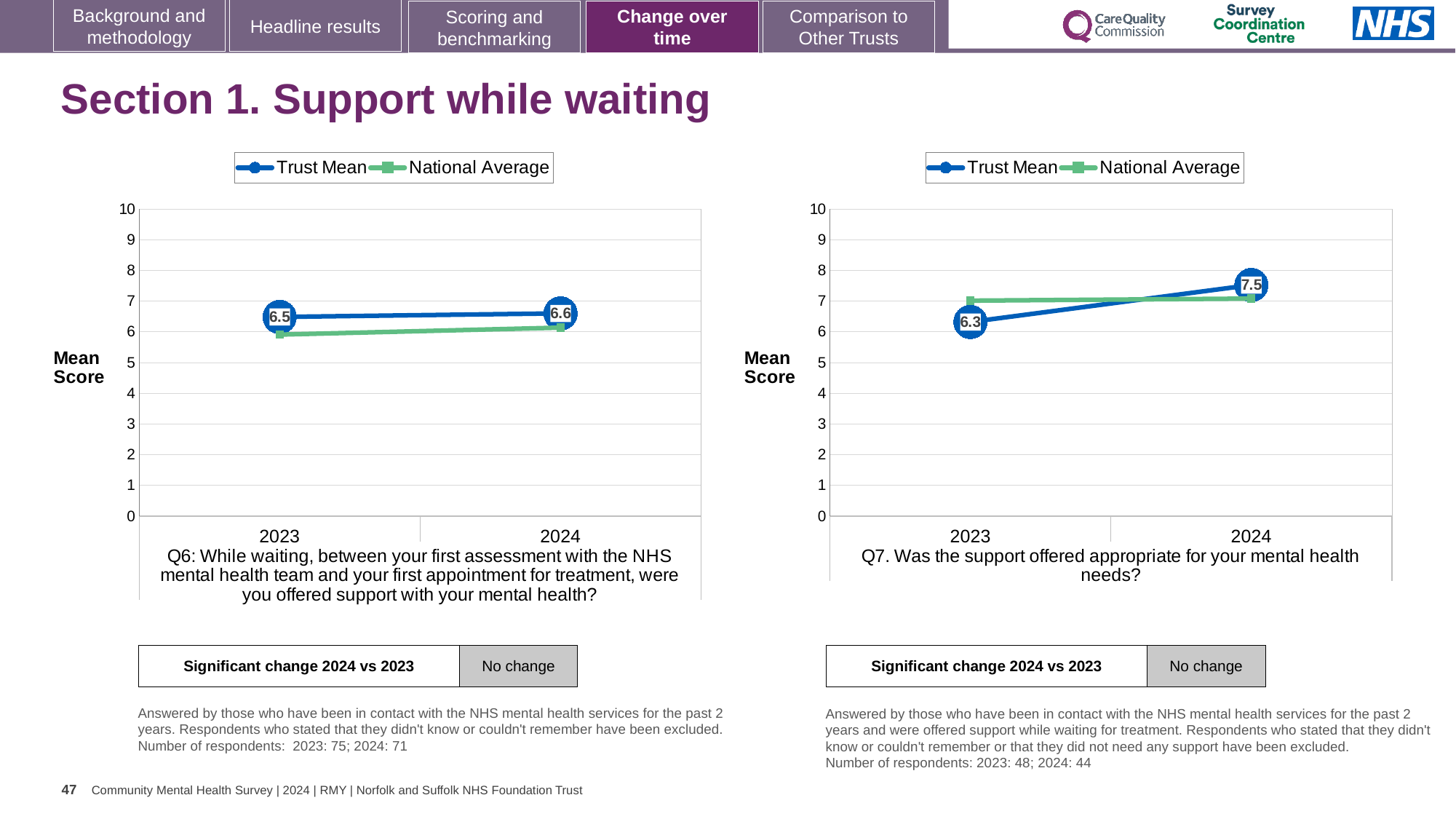
In the right chart (Q7), does the Trust Mean rise or fall from 2023 to 2024? rise In the right chart (Q7), what is the Trust Mean for 2024? 7.5 In the right chart (Q7), what is the Trust Mean for 2023? 6.3 In the right chart (Q7), is the National Average for 2023 greater or less than 6? greater In the left chart (Q6), what is the Trust Mean for 2023? 6.5 How many series does the legend of the left chart (Q6) list? 2 What kind of chart is the left chart (Q6)? line chart In the left chart (Q6), is the National Average for 2023 greater or less than 7? less In the right chart (Q7), which year has the higher Trust Mean, 2023 or 2024? 2024 How many years are plotted on the x axis of the right chart (Q7)? 2 In the left chart (Q6), what is the Trust Mean for 2024? 6.6 In the right chart (Q7), by how much did the Trust Mean change from 2023 to 2024? 1.2